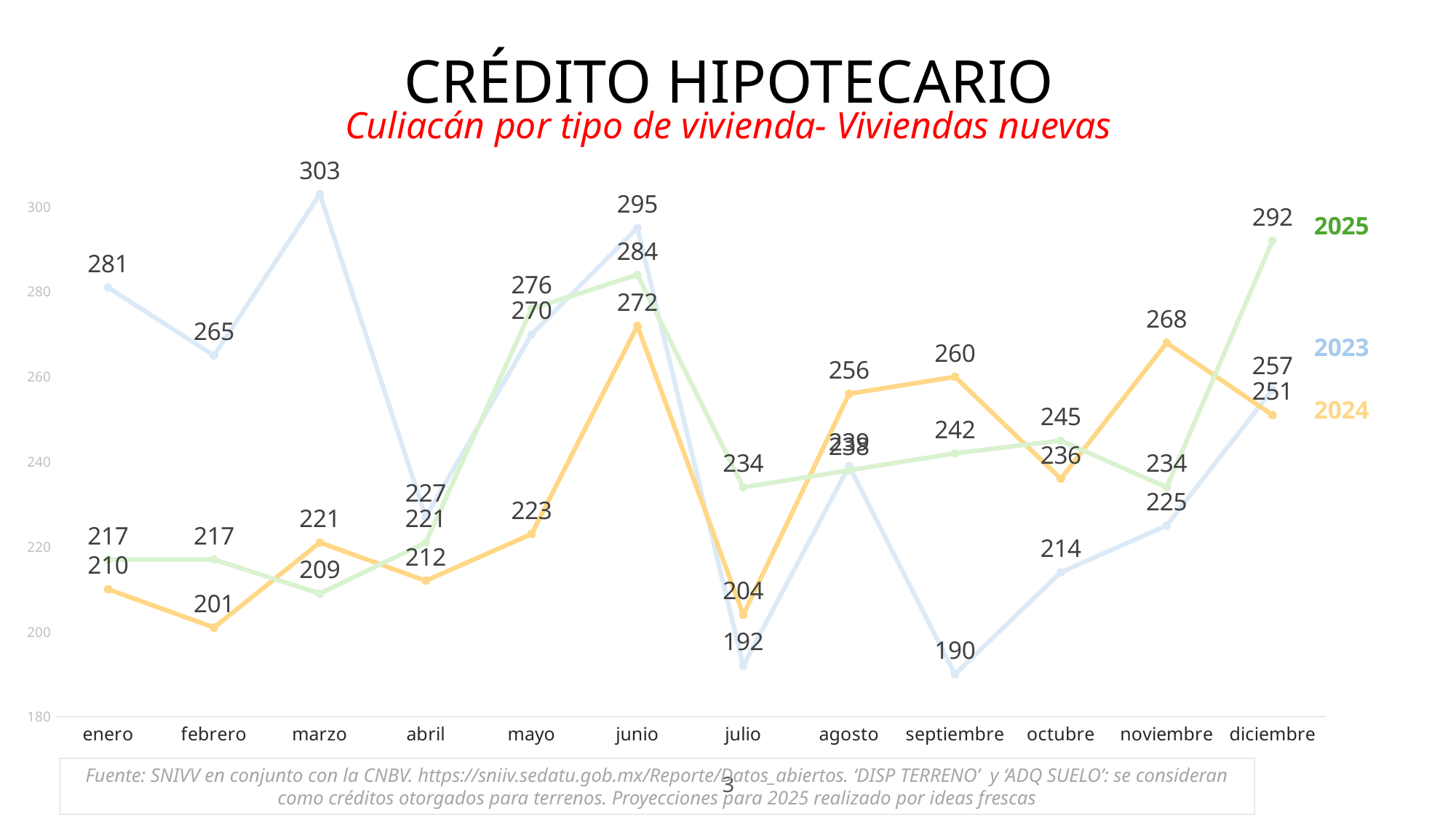
How many months are plotted along the x axis? 12 In which month does the 2024 series reach its lowest value? febrero Which series has the larger value in junio, 2023 or 2025? 2023 What is the value for 2023 in marzo? 303 Does the 2023 series rise or fall from septiembre to diciembre? rise What is the difference between the 2023 and 2024 values in marzo? 82 How many series does the legend list? 3 In which month does the 2023 series reach its lowest value? septiembre What kind of chart is shown on the slide? line chart In which month does the 2023 series reach its highest value? marzo What is the value for 2025 in diciembre? 292 What is the value for 2024 in noviembre? 268